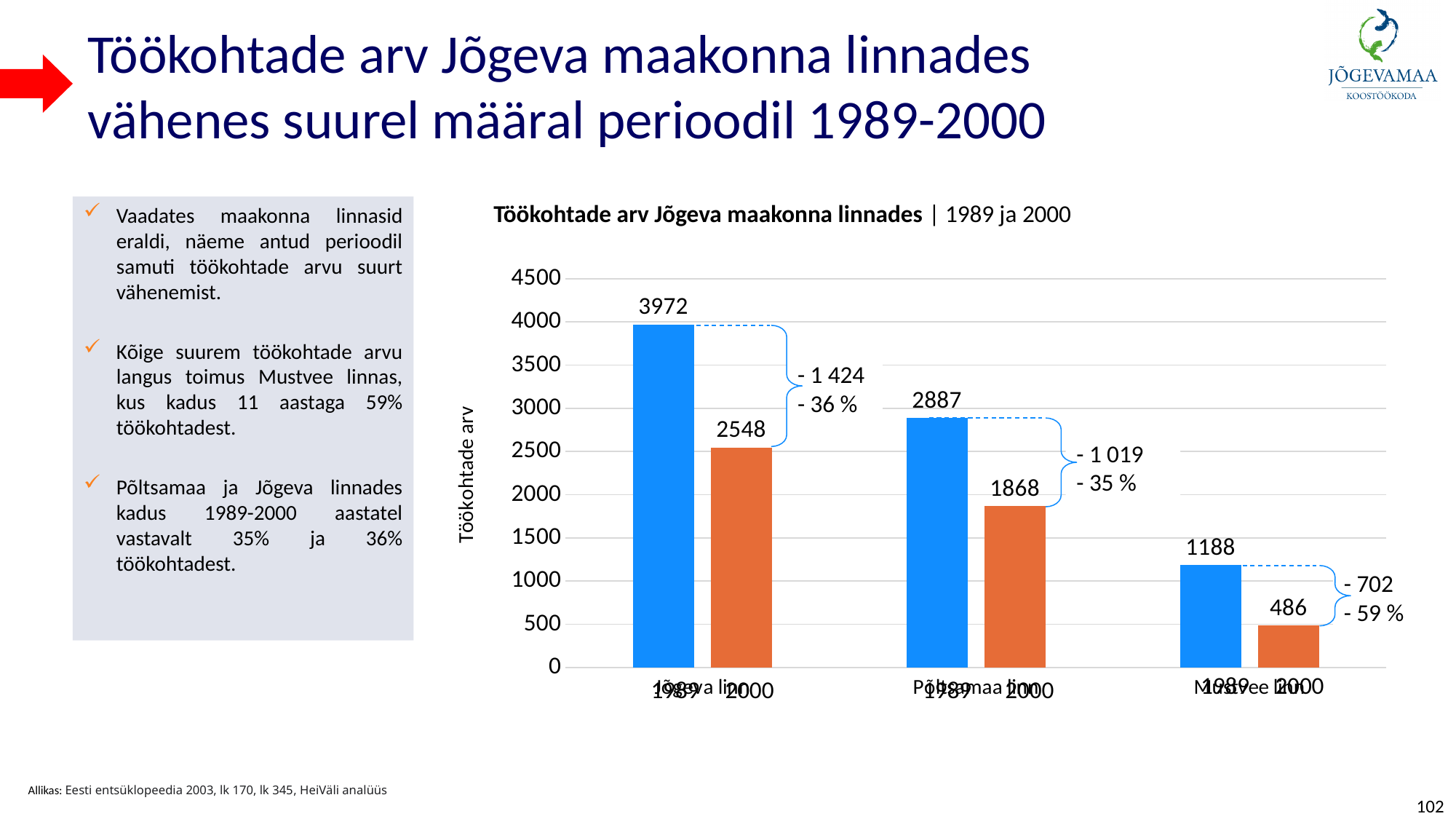
What is the difference between the 1989 and 2000 job counts for Mustvee linn? 702 What percentage decrease is annotated for Mustvee linn? - 59 % How many towns are shown on the x axis of the chart? 3 Which is larger: the 2000 value for Jõgeva linn or the 1989 value for Põltsamaa linn? 1989 value for Põltsamaa linn Which town had the lowest number of jobs in 2000? Mustvee linn By how much did the number of jobs in Jõgeva linn fall between 1989 and 2000? 1 424 What was the number of jobs in Mustvee linn in 2000? 486 What was the number of jobs in Jõgeva linn in 1989? 3972 Is the 1989 value for Mustvee linn greater or less than 1000? greater What kind of chart is shown on the slide? Bar chart Which town had the highest number of jobs in 1989? Jõgeva linn What was the number of jobs in Põltsamaa linn in 2000? 1868